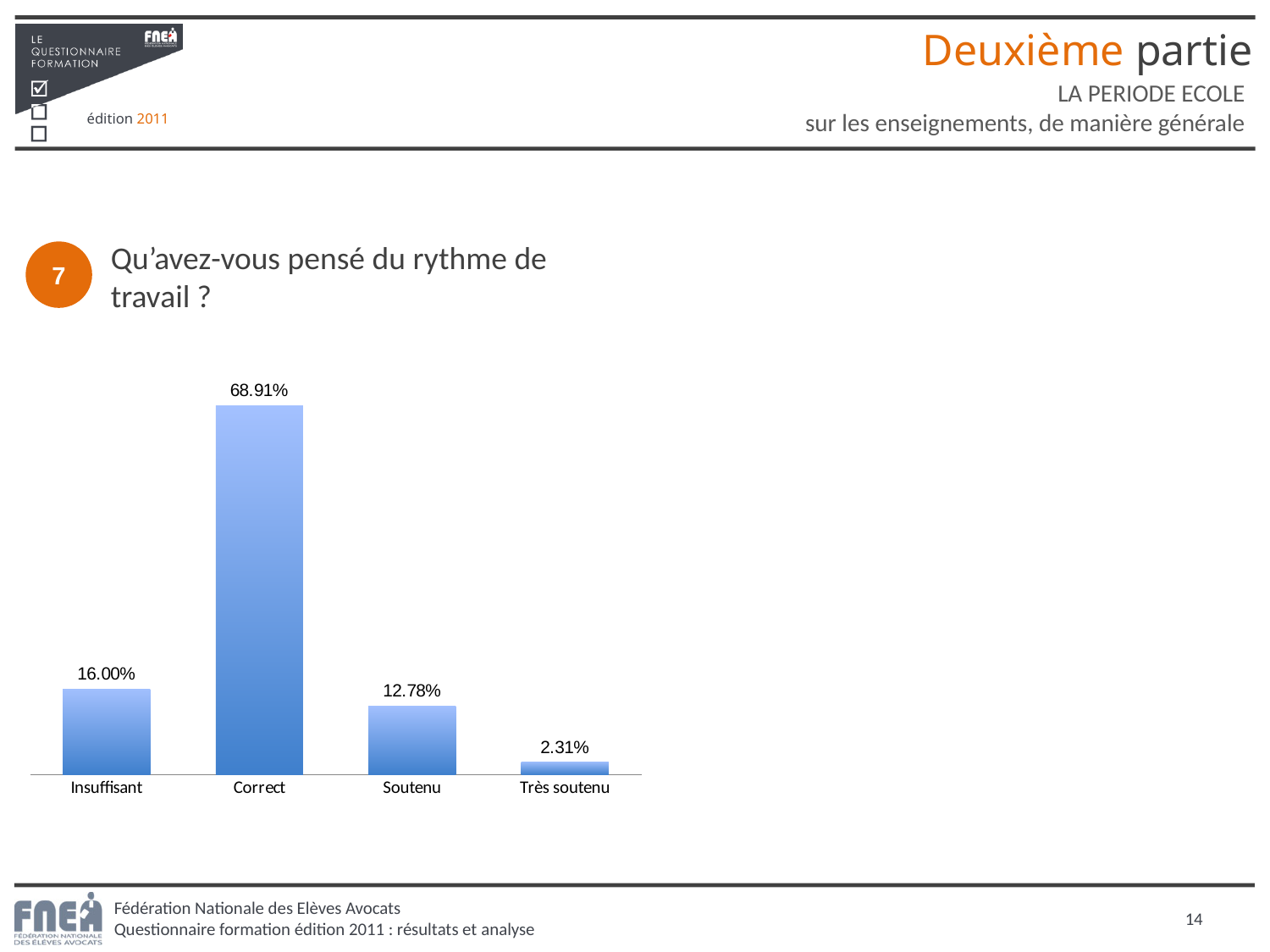
What is the value shown for "Insuffisant"? 16.00% What is the difference between the values for "Soutenu" and "Très soutenu"? 10.47% What is the difference between the values for "Correct" and "Insuffisant"? 52.91% What kind of chart is shown on the slide? Bar chart Which category has the lowest value? Très soutenu What question does the chart answer, according to the slide? Qu'avez-vous pensé du rythme de travail ? What is the value shown for "Soutenu"? 12.78% What is the value shown for "Très soutenu"? 2.31% What percentage of respondents rated the work rhythm as "Correct"? 68.91% How many categories are shown in the chart? 4 Which is larger, the value for "Insuffisant" or the value for "Soutenu"? Insuffisant Which category has the highest value? Correct